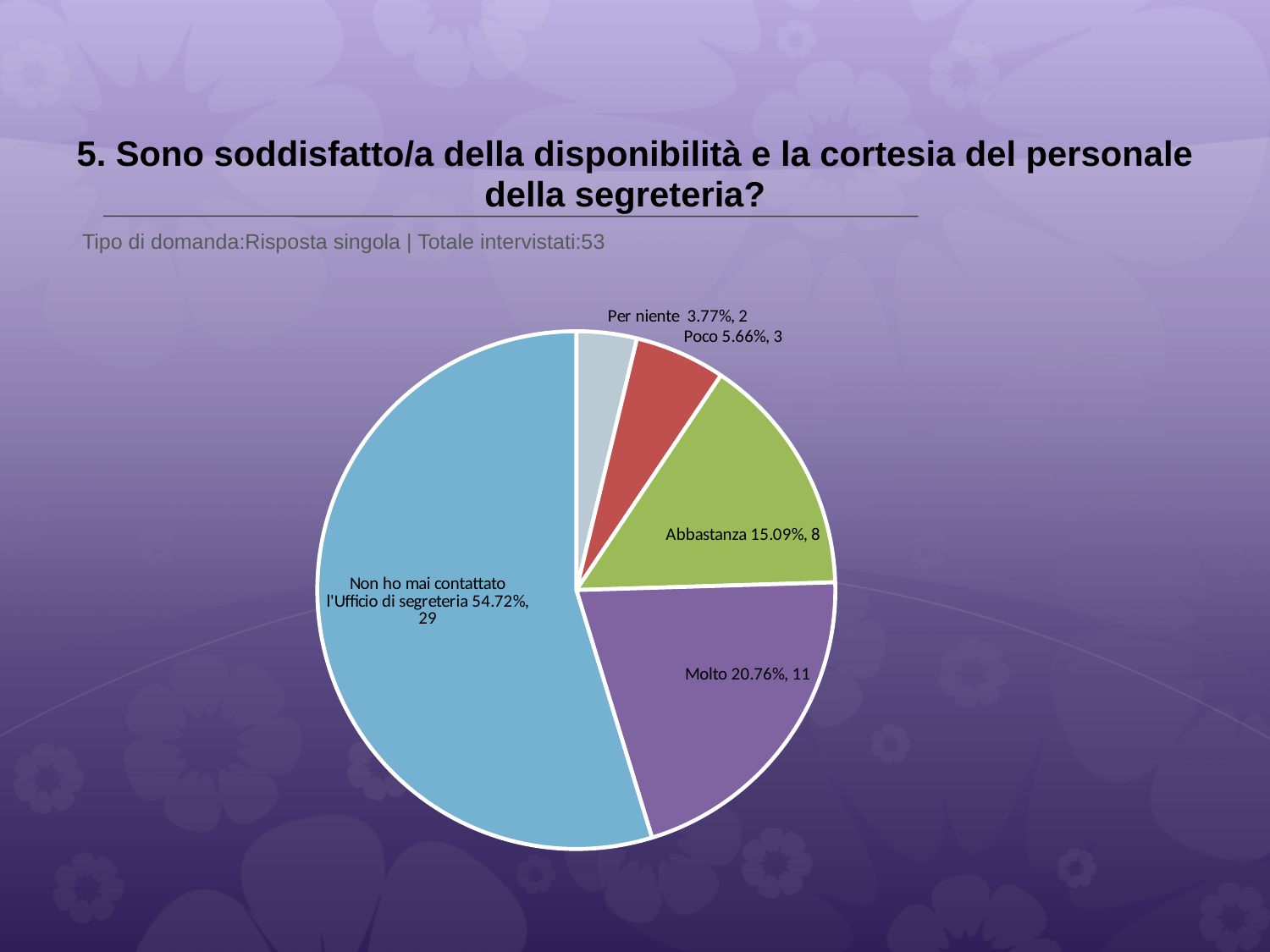
How many respondents answered 'Abbastanza'? 8 What percentage share does the 'Molto' slice have? 20.76% What is the total number of respondents stated on the slide? 53 Which has more respondents, 'Poco' or 'Per niente'? Poco How many respondents answered 'Poco'? 3 What colour is the 'Molto' slice? purple How many slices does the pie chart have? 5 Which category has the largest slice of the pie? Non ho mai contattato l'Ufficio di segreteria Which category has the smallest slice of the pie? Per niente What is the difference in respondent count between 'Molto' and 'Abbastanza'? 3 What percentage share does the 'Non ho mai contattato l'Ufficio di segreteria' slice have? 54.72% What kind of chart is shown on the slide? pie chart